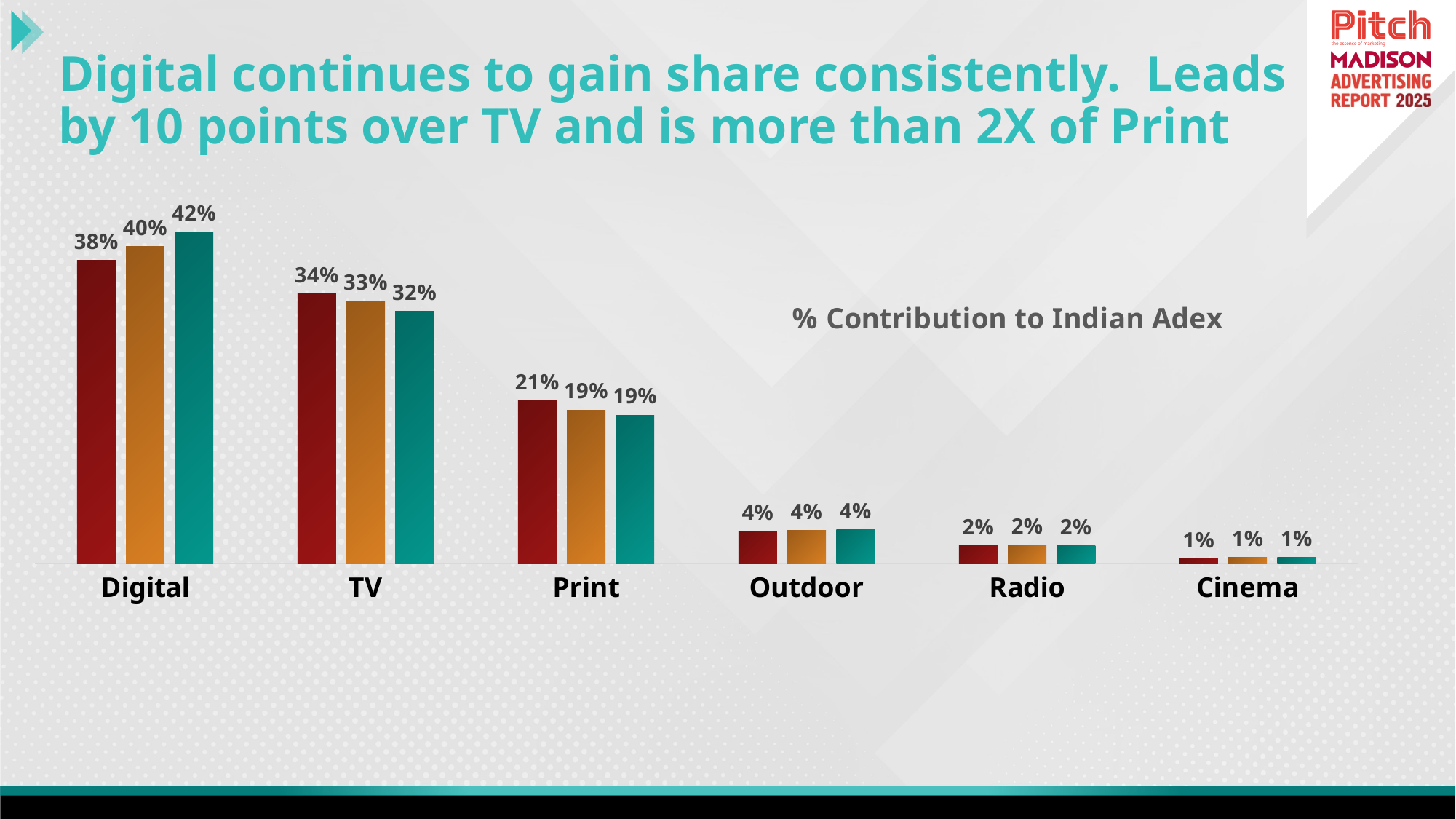
What is the difference between the teal bar for Digital (42%) and the teal bar for TV (32%)? 10% What is the value of the red (leftmost) bar for TV? 34% What kind of chart is shown on the slide? Bar chart Which category has the lowest values in the chart? Cinema What is the value shown for each of the three bars for Outdoor? 4% Which category has the highest values in the chart? Digital What is the value of the orange (middle) bar for Print? 19% Which is larger: the red bar for Print or the red bar for Outdoor? Print What is the value of the teal (rightmost) bar for Digital? 42% How many categories are shown on the x axis? 6 Do the values for Digital rise or fall from the red bar to the teal bar? Rise How many bars are shown for each category? 3